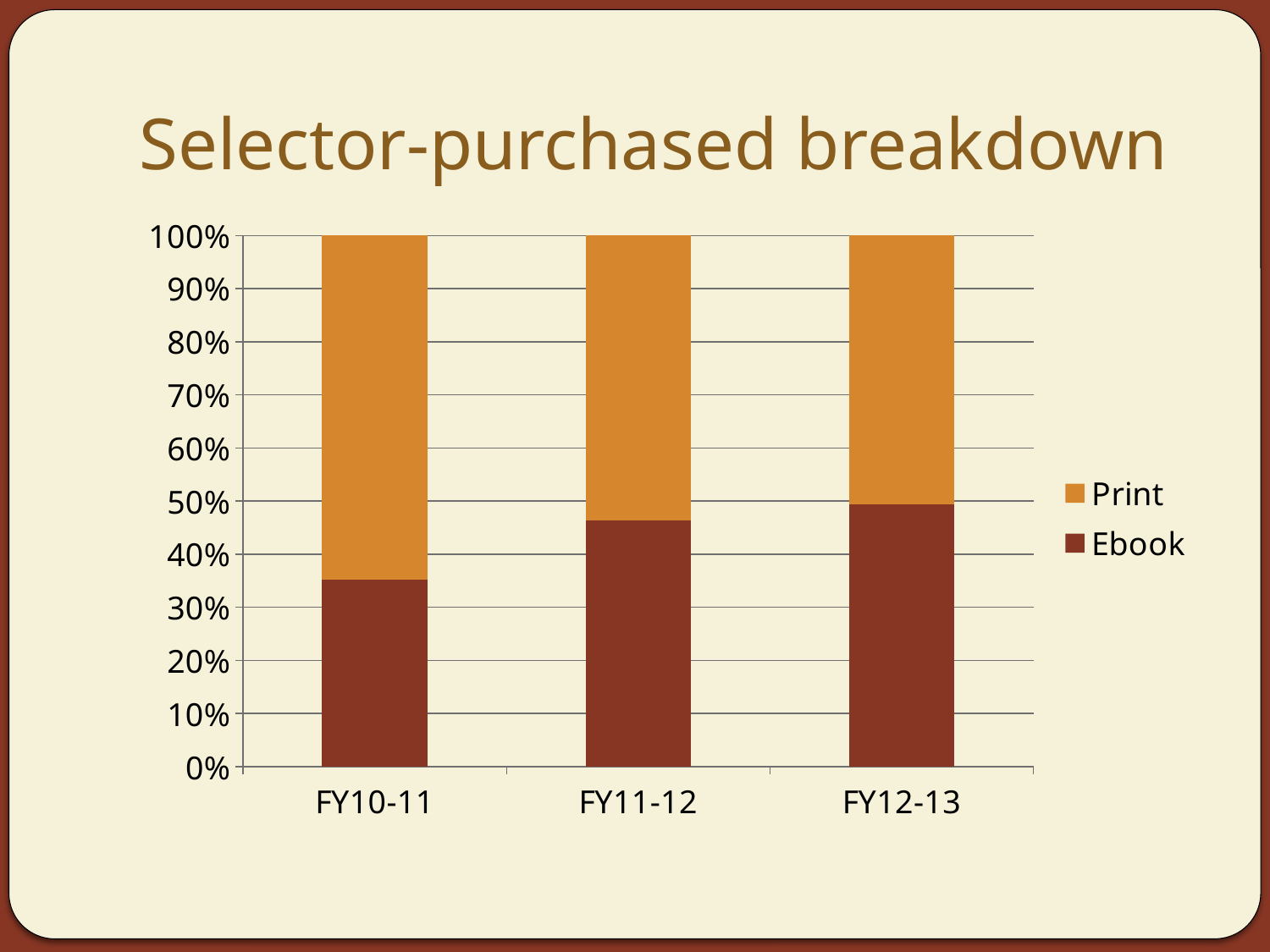
How many series does the legend list? 2 What kind of chart is shown on the slide? Stacked bar chart How many fiscal years are shown on the x axis? 3 What are the two series named in the legend? Print and Ebook Is the Ebook share for FY10-11 greater or less than 40%? less In which fiscal year is the Ebook share the lowest? FY10-11 Is the Ebook share for FY10-11 greater or less than 30%? greater Which has the larger Ebook share, FY10-11 or FY11-12? FY11-12 Is the Ebook share for FY11-12 greater or less than 40%? greater What is the title of the chart? Selector-purchased breakdown Does the Ebook share rise or fall from FY10-11 to FY12-13? rise In which fiscal year is the Print share the highest? FY10-11